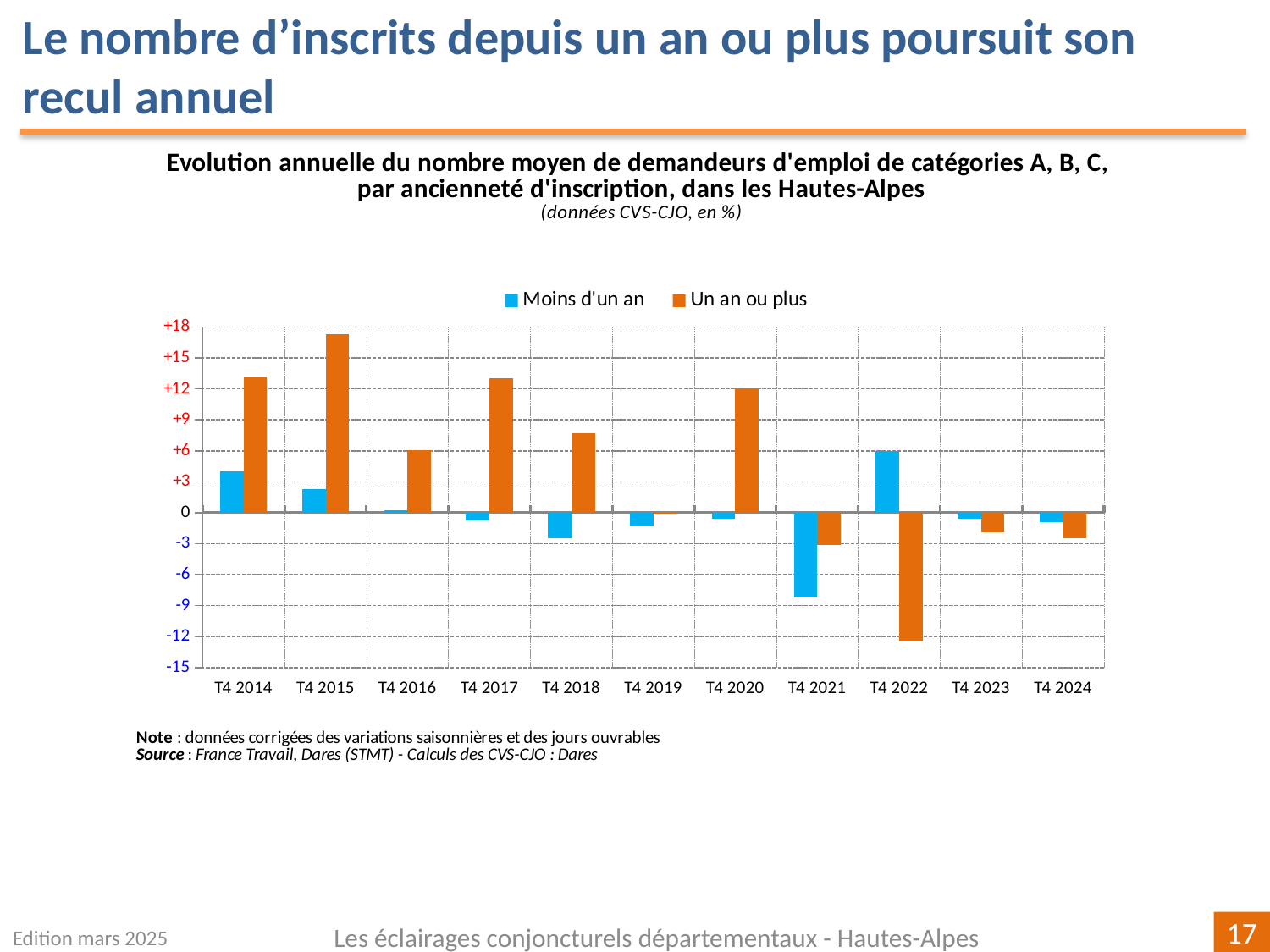
Is the value for 'Moins d'un an' in T4 2021 greater or less than -6? less In which quarter is the value for 'Moins d'un an' the lowest? T4 2021 In which quarter is the value for 'Moins d'un an' the highest? T4 2022 How many quarters (categories) are shown on the x axis? 11 How many series does the legend list? 2 In which quarter is the value for 'Un an ou plus' the lowest? T4 2022 What kind of chart is shown on the slide? bar chart Which colour represents the 'Un an ou plus' series? orange In T4 2014, which series has the larger value: 'Moins d'un an' or 'Un an ou plus'? Un an ou plus Is the value for 'Un an ou plus' in T4 2015 greater or less than +15? greater In which quarter is the value for 'Un an ou plus' the highest? T4 2015